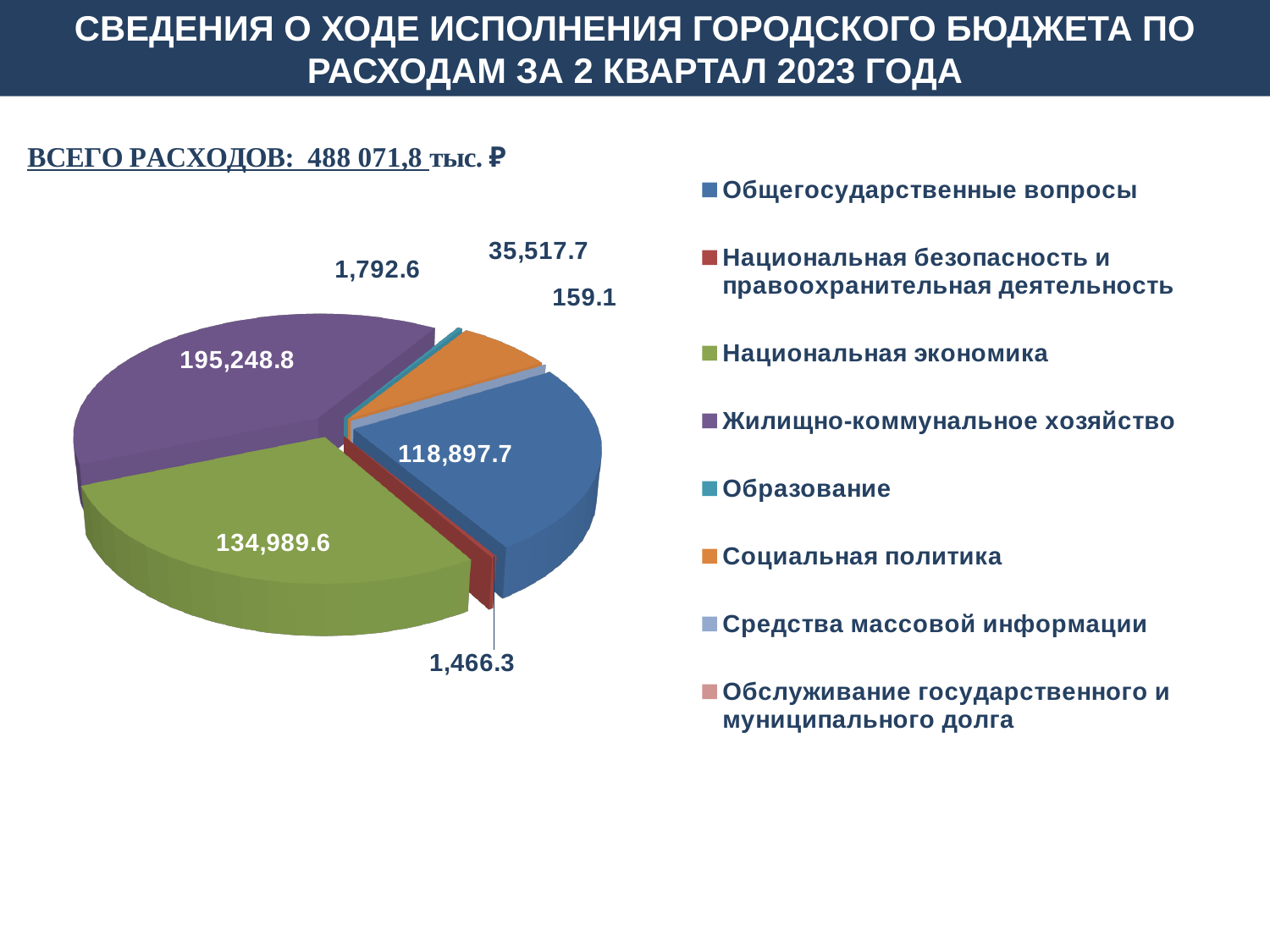
Which is larger, Национальная экономика or Общегосударственные вопросы? Национальная экономика How many categories does the legend list? 8 What is the value for Общегосударственные вопросы? 118,897.7 What is the difference between Жилищно-коммунальное хозяйство and Национальная экономика? 60,259.2 What colour is the slice for Национальная экономика? green What is the value for Национальная экономика? 134,989.6 What is the value for Социальная политика? 35,517.7 What type of chart is shown on the slide? pie chart Which category has the largest slice of the pie? Жилищно-коммунальное хозяйство What total expenditure is stated on the slide? 488 071,8 тыс. ₽ What is the value for Национальная безопасность и правоохранительная деятельность? 1,466.3 What is the value for Жилищно-коммунальное хозяйство? 195,248.8